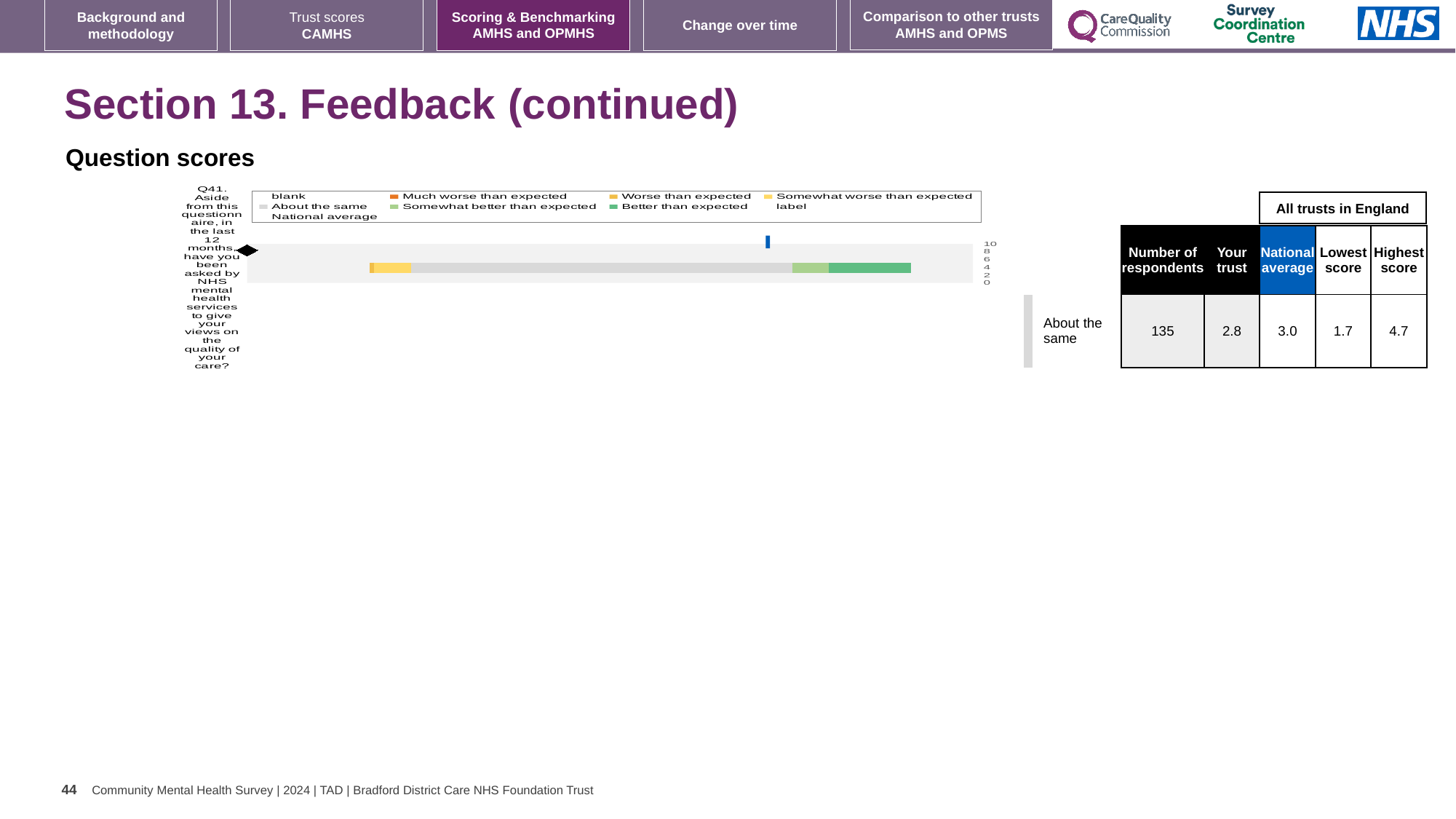
What is the lowest score among all trusts in England for Q41? 1.7 What is the highest score among all trusts in England for Q41? 4.7 For Q41, what is the difference between the highest score and the lowest score among all trusts in England? 3.0 Which question number is plotted in the chart on the slide? Q41 How many questions are plotted in the chart on the slide? 1 What is the 'Your trust' score for Q41 shown in the table beside the chart? 2.8 Which benchmark category label is shown next to the Q41 chart for the trust's result? About the same For Q41, which is larger: the 'Your trust' score or the national average? National average What is the national average score for Q41 shown in the table beside the chart? 3.0 How many entries does the legend of the Q41 chart list? 9 How many respondents are shown for Q41 in the table beside the chart? 135 What kind of chart is shown on the slide for Q41? bar chart